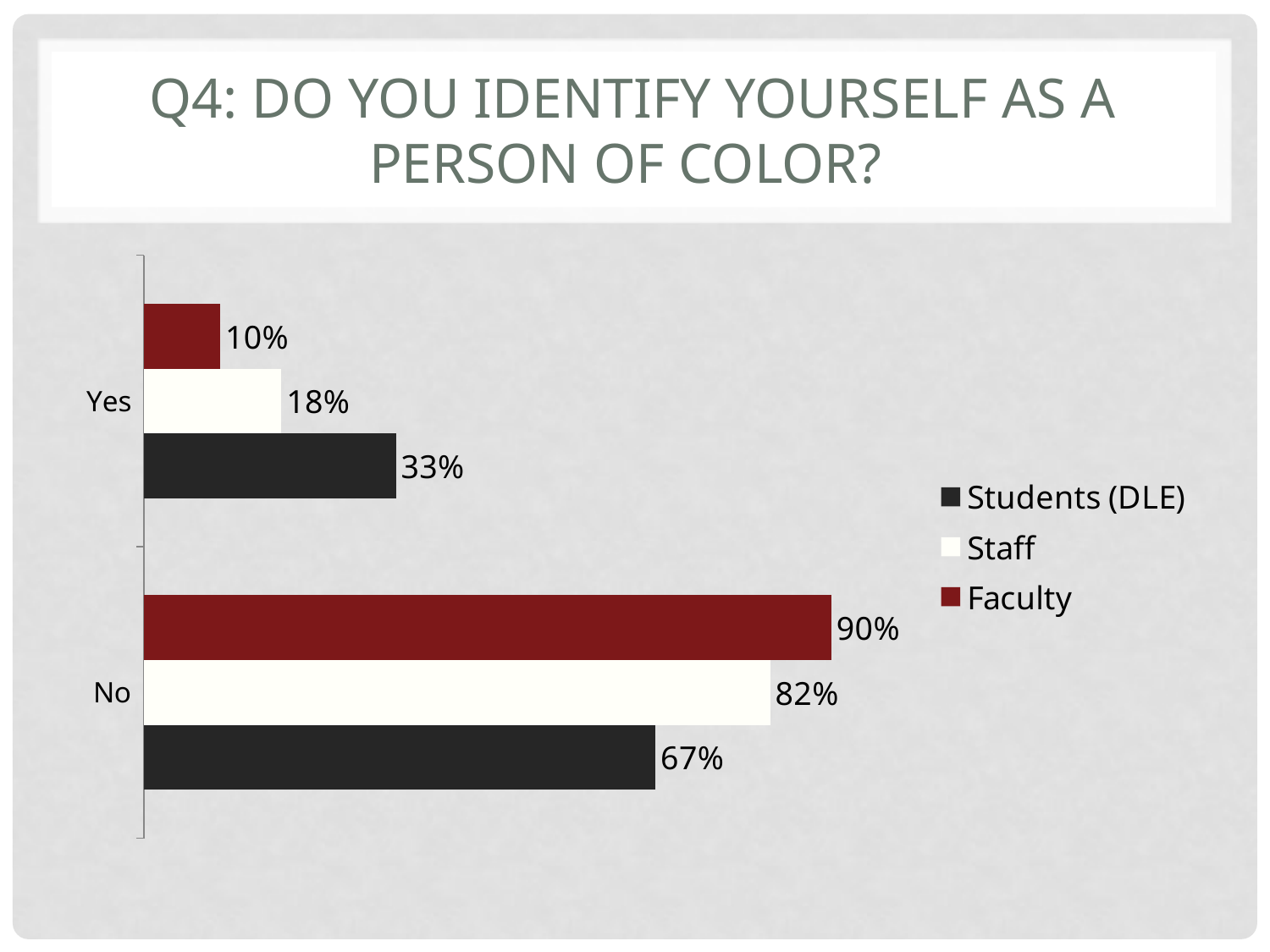
Which group has the highest percentage answering No? Faculty How many series does the legend list? 3 What is the difference between the Faculty and Students (DLE) percentages for No? 23% What percentage of Faculty answered Yes? 10% Which colour represents Faculty in the chart? Dark red Which group has the lowest percentage answering Yes? Faculty How many response categories are shown on the chart? 2 What kind of chart is shown on the slide? Bar chart What is the difference between the Staff and Faculty percentages for Yes? 8% Which is larger: the Students (DLE) percentage for Yes or the Staff percentage for Yes? Students (DLE) What percentage of Students (DLE) answered Yes? 33% What percentage of Staff answered No? 82%